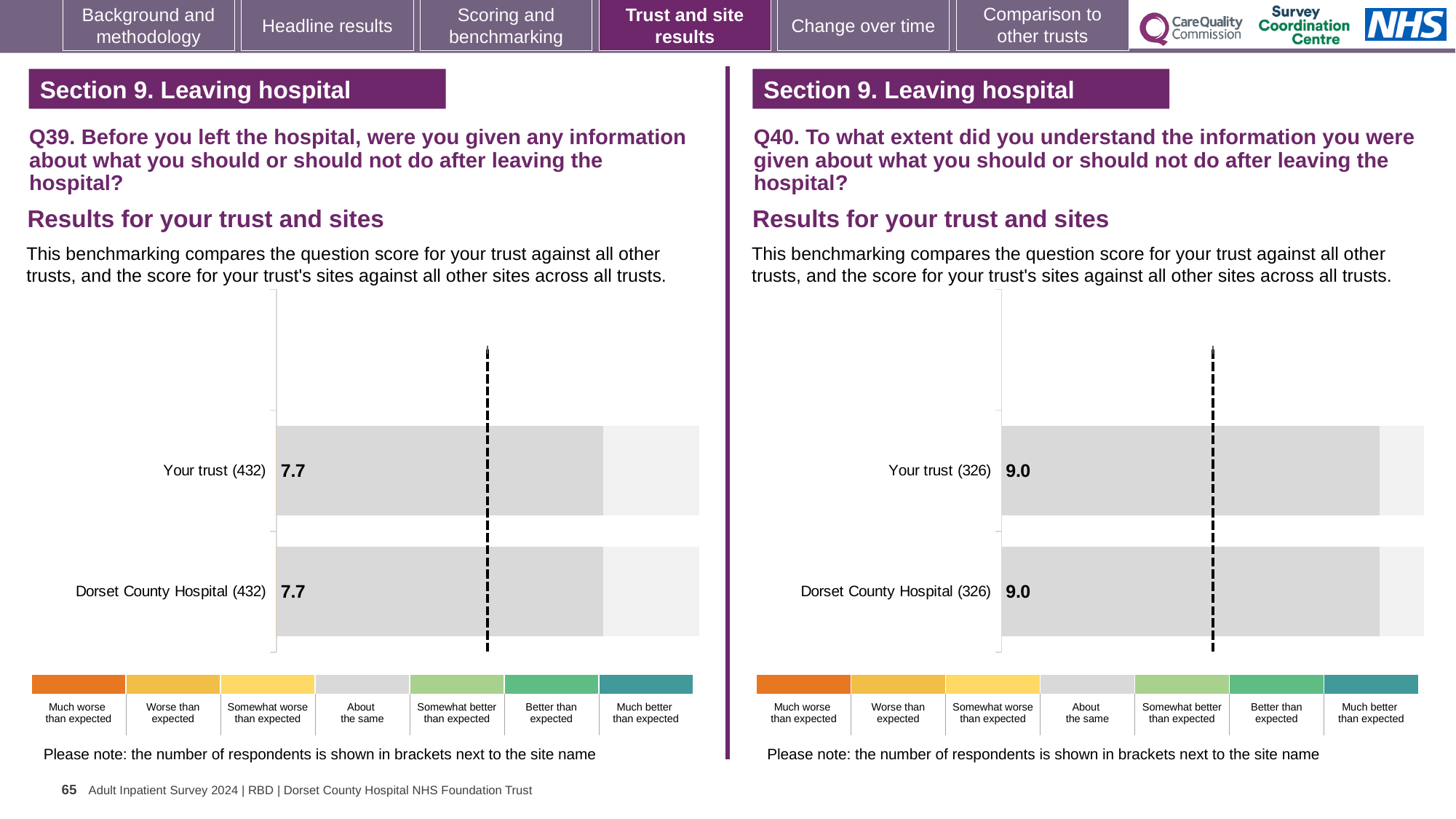
In the Q40 chart on the right, what is the difference between the score for Your trust and the score for Dorset County Hospital? 0.0 In the Q39 chart on the left, what is the difference between the score for Your trust and the score for Dorset County Hospital? 0.0 How many categories does the colour key below the Q40 chart on the right list? 7 In the Q39 chart on the left, how many respondents are shown in brackets for Your trust? 432 How many bars are plotted in the Q40 chart on the right? 2 In the Q39 chart on the left, what is the score for Dorset County Hospital? 7.7 In the Q40 chart on the right, what is the score for Dorset County Hospital? 9.0 In the Q39 chart on the left, what is the score for Your trust? 7.7 In the Q40 chart on the right, what is the score for Your trust? 9.0 How many bars are plotted in the Q39 chart on the left? 2 What kind of chart is used in the Q39 chart on the left? Bar chart In the Q40 chart on the right, how many respondents are shown in brackets for Dorset County Hospital? 326